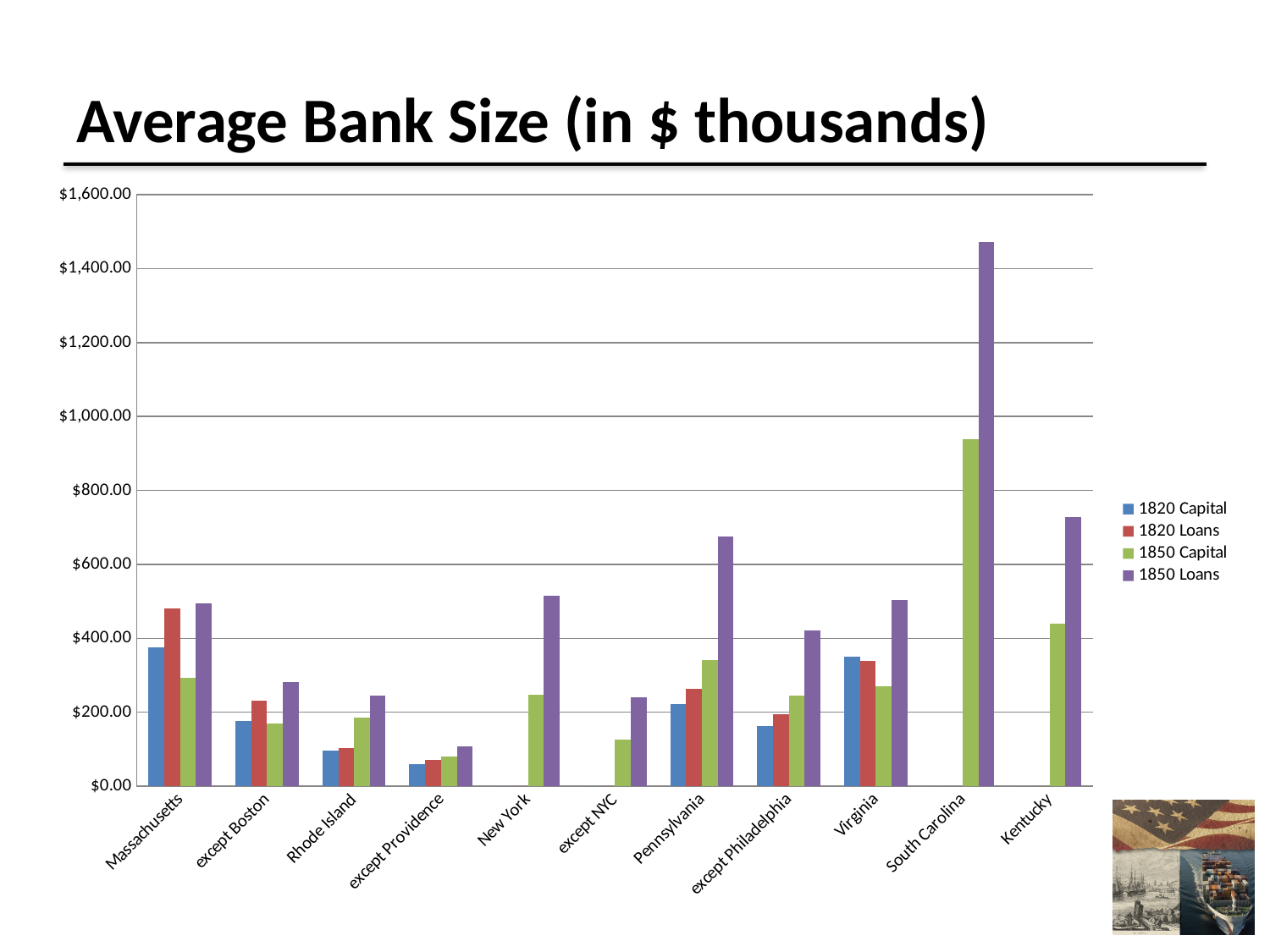
Which category has the lowest 1850 Loans value? except Providence Which category has the highest 1850 Capital value? South Carolina What kind of chart is shown on the slide? bar chart How many categories are shown along the x axis? 11 Which category has the highest 1850 Loans value? South Carolina Is the 1820 Capital value for Massachusetts greater or less than $400.00? less Which colour represents the 1850 Loans series in the legend? purple How many series does the legend list? 4 What is the title of the chart? Average Bank Size (in $ thousands) Is the 1850 Loans value for South Carolina greater or less than $1,400.00? greater Is the 1850 Loans value for Kentucky greater or less than $600.00? greater For Massachusetts, which is larger: 1820 Loans or 1850 Capital? 1820 Loans